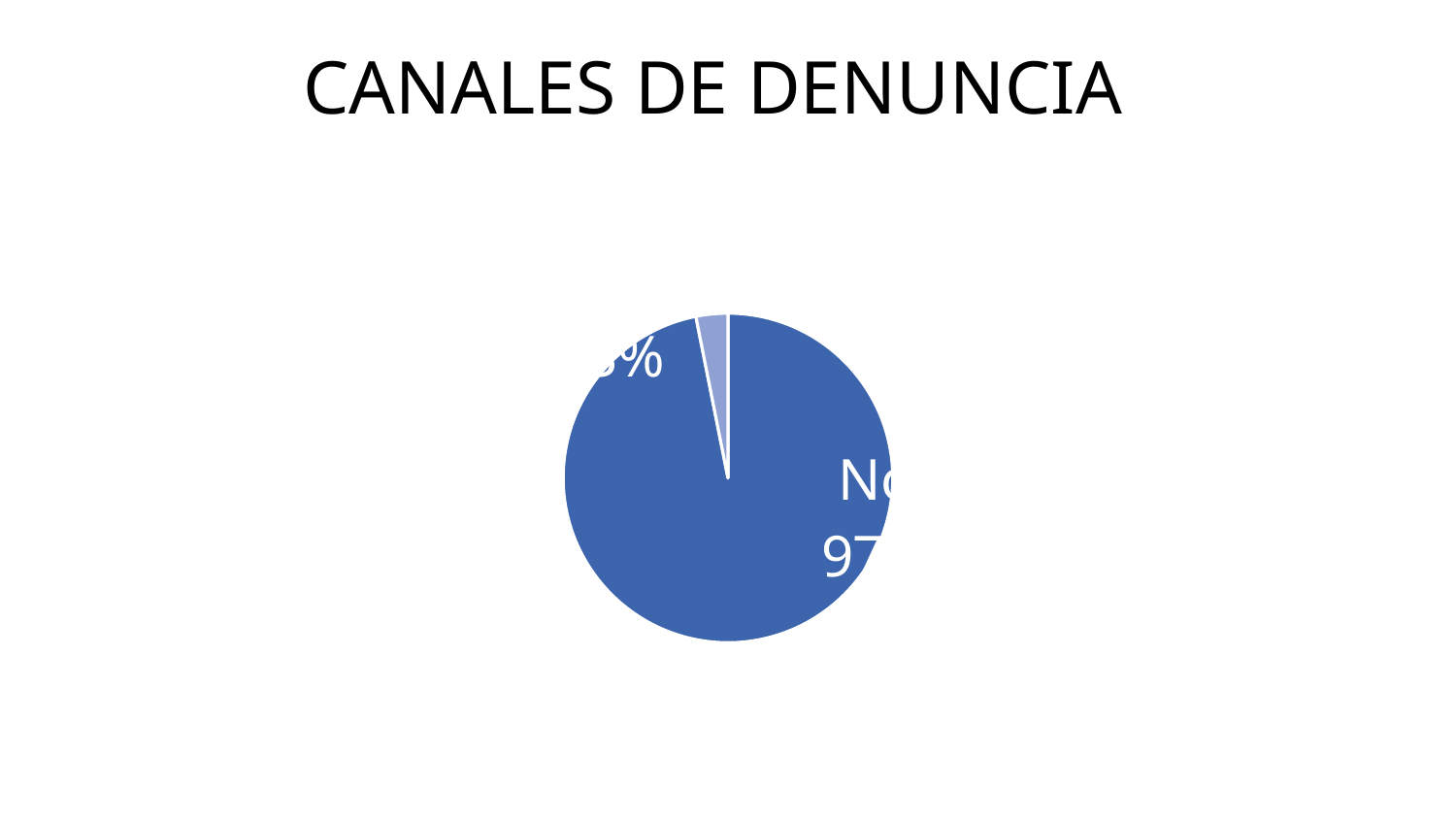
What is the title of the chart? CANALES DE DENUNCIA Which slice is larger, the dark blue slice or the light blue slice? the dark blue slice What kind of chart is shown on the slide? pie chart Does the chart show a legend? No Which slice of the pie chart is the smallest? the light blue slice How many slices does the pie chart have? 2